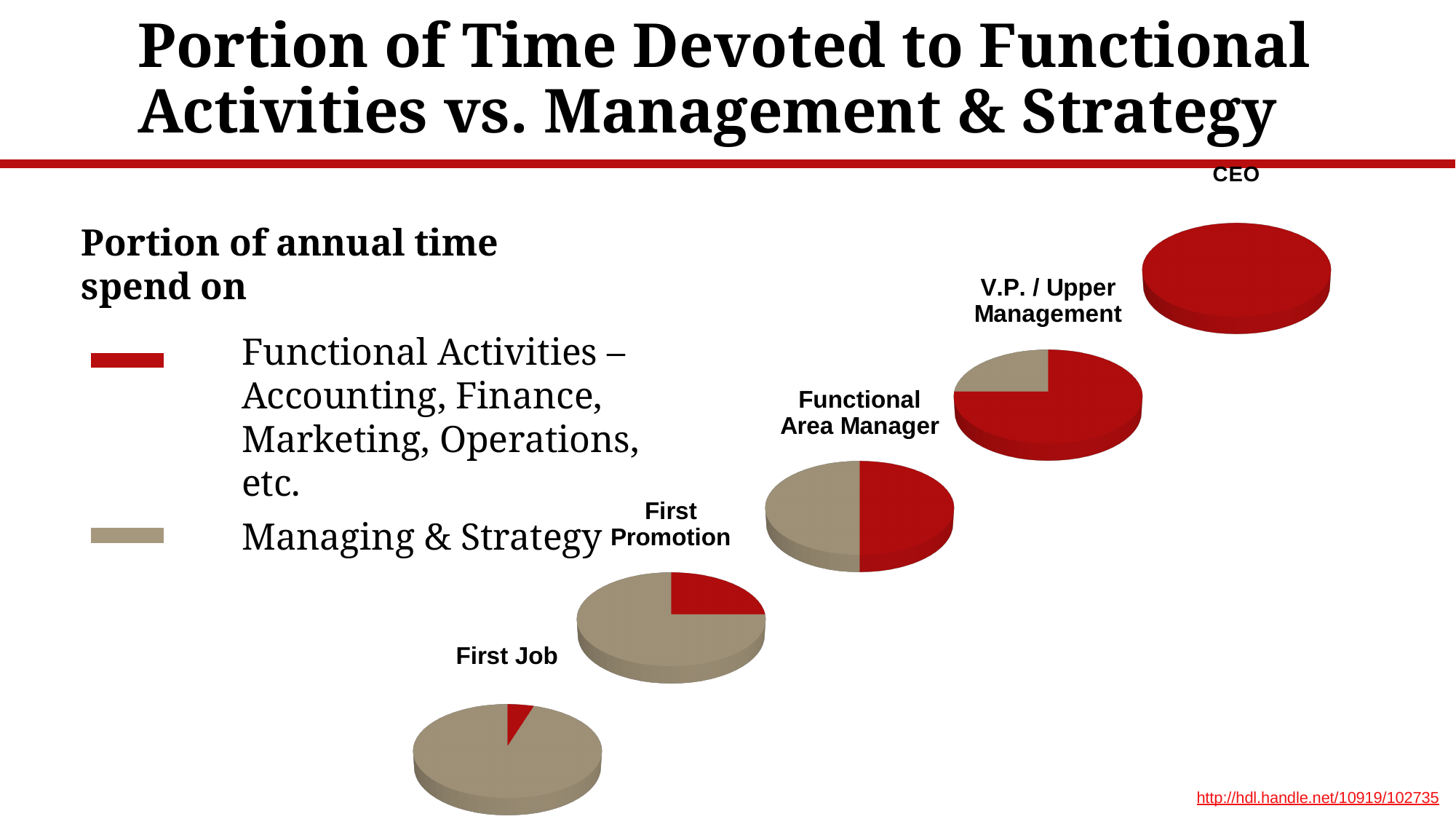
How many pie charts are shown on the slide? 5 Which pie chart has the smallest share for Functional Activities (red)? First Job Which pie chart has the largest share for Managing & Strategy? First Job In the First Job pie chart, which is larger: Functional Activities or Managing & Strategy? Managing & Strategy Which colour represents Functional Activities in the legend? Red In the V.P. / Upper Management pie chart, which is larger: Functional Activities or Managing & Strategy? Functional Activities What kind of charts are shown on the slide? Pie charts How many series does the legend list? 2 Which pie chart has the largest share for Functional Activities (red)? CEO What is the label of the pie chart at the top right of the slide? CEO In the First Promotion pie chart, which is larger: Functional Activities or Managing & Strategy? Managing & Strategy Does the share of Functional Activities rise or fall from First Job to CEO? Rise